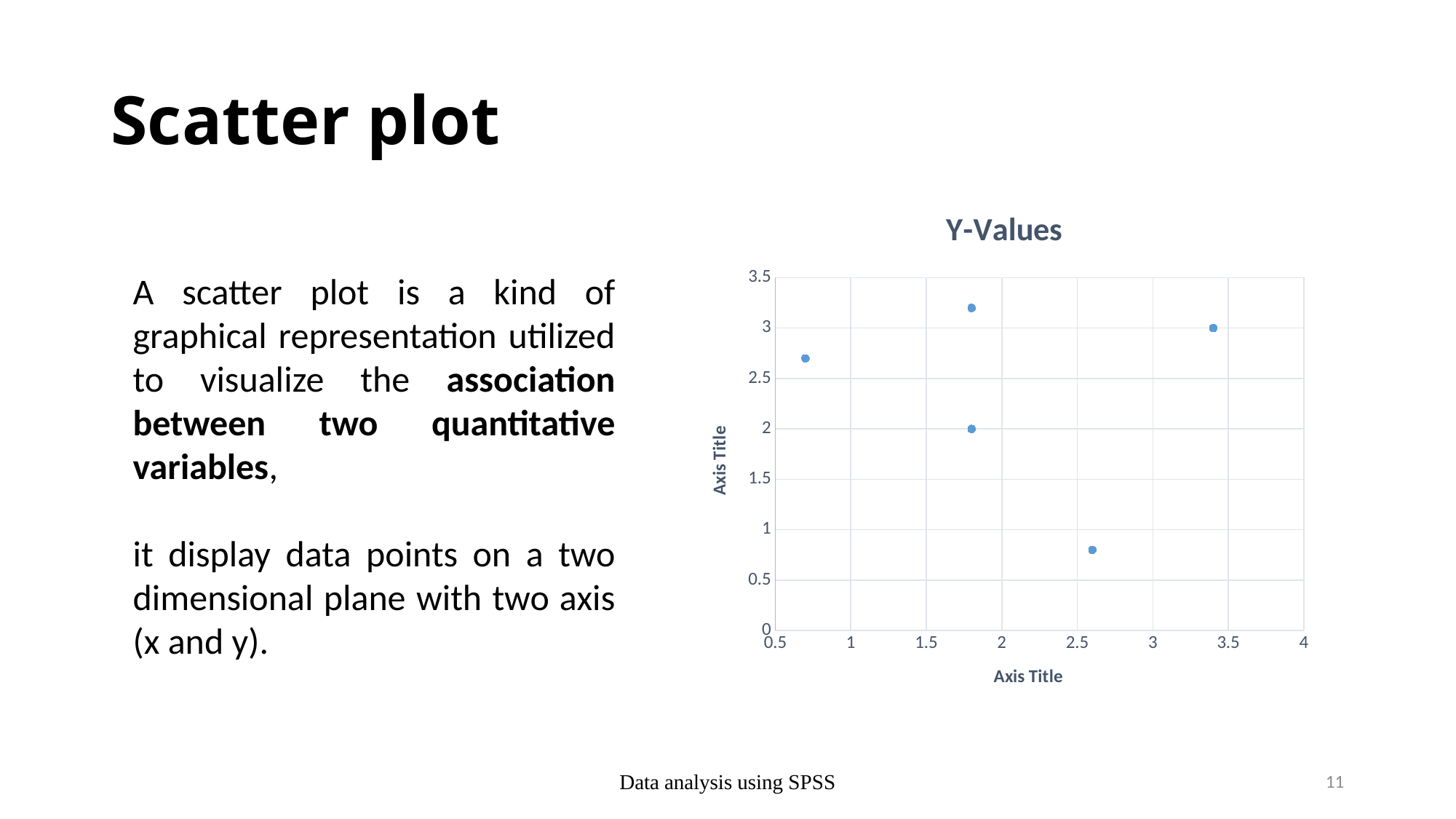
Is the y-value of the point located between x = 2.5 and x = 3 greater or less than 1? less How many points in the chart have an x-value greater than 3? 1 What is the title of the chart? Y-Values Is the y-value of the lowest point in the chart greater or less than 1? less Is the highest point in the chart located to the left or to the right of x = 2? left How many points in the chart have a y-value greater than 2.5? 3 How many data points are plotted in the chart? 5 What is the label shown on the horizontal axis of the chart? Axis Title Is the y-value of the leftmost point (near x = 0.5–1) greater or less than 2.5? greater What kind of chart is shown on the slide? Scatter plot